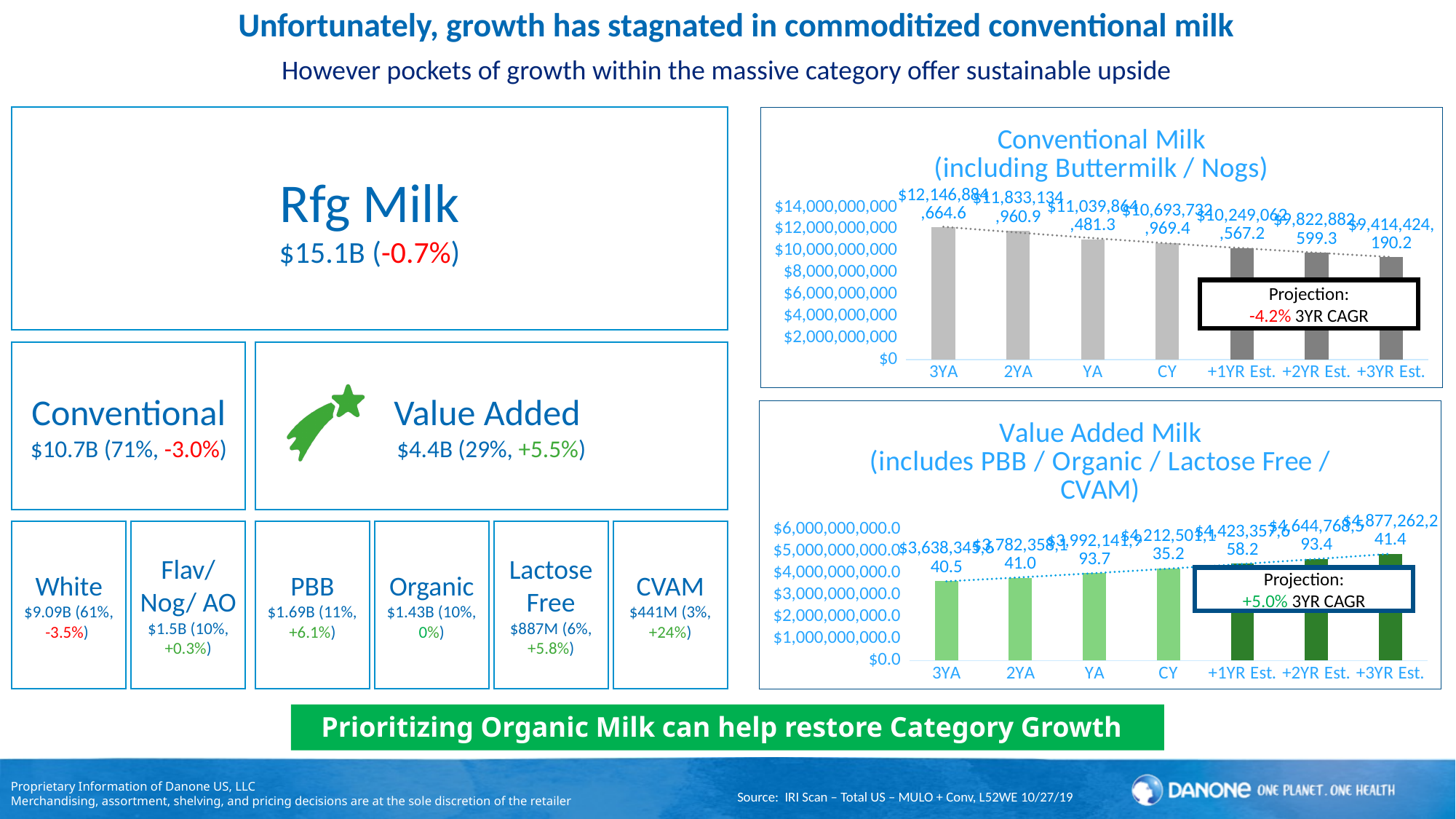
How many bars are plotted in the Value Added Milk chart? 7 In the Value Added Milk chart, which period has the lowest value? 3YA In the Conventional Milk chart, is the value for +3YR Est. greater or less than $10,000,000,000? less In the Conventional Milk chart, which is larger, the value for 3YA or the value for +3YR Est.? 3YA What 3YR CAGR projection is shown in the box on the Conventional Milk chart? -4.2% What kind of chart is the Conventional Milk (including Buttermilk / Nogs) chart? bar chart In the Value Added Milk chart, do the values rise or fall from 3YA to +3YR Est.? rise In the Value Added Milk chart, is the value for 3YA greater or less than $4,000,000,000.0? less In the Conventional Milk chart, do the values rise or fall from 3YA to +3YR Est.? fall In the Conventional Milk chart, which period has the highest value? 3YA In the Value Added Milk chart, is the value for +3YR Est. greater or less than $4,000,000,000.0? greater What 3YR CAGR projection is shown in the box on the Value Added Milk chart? +5.0%